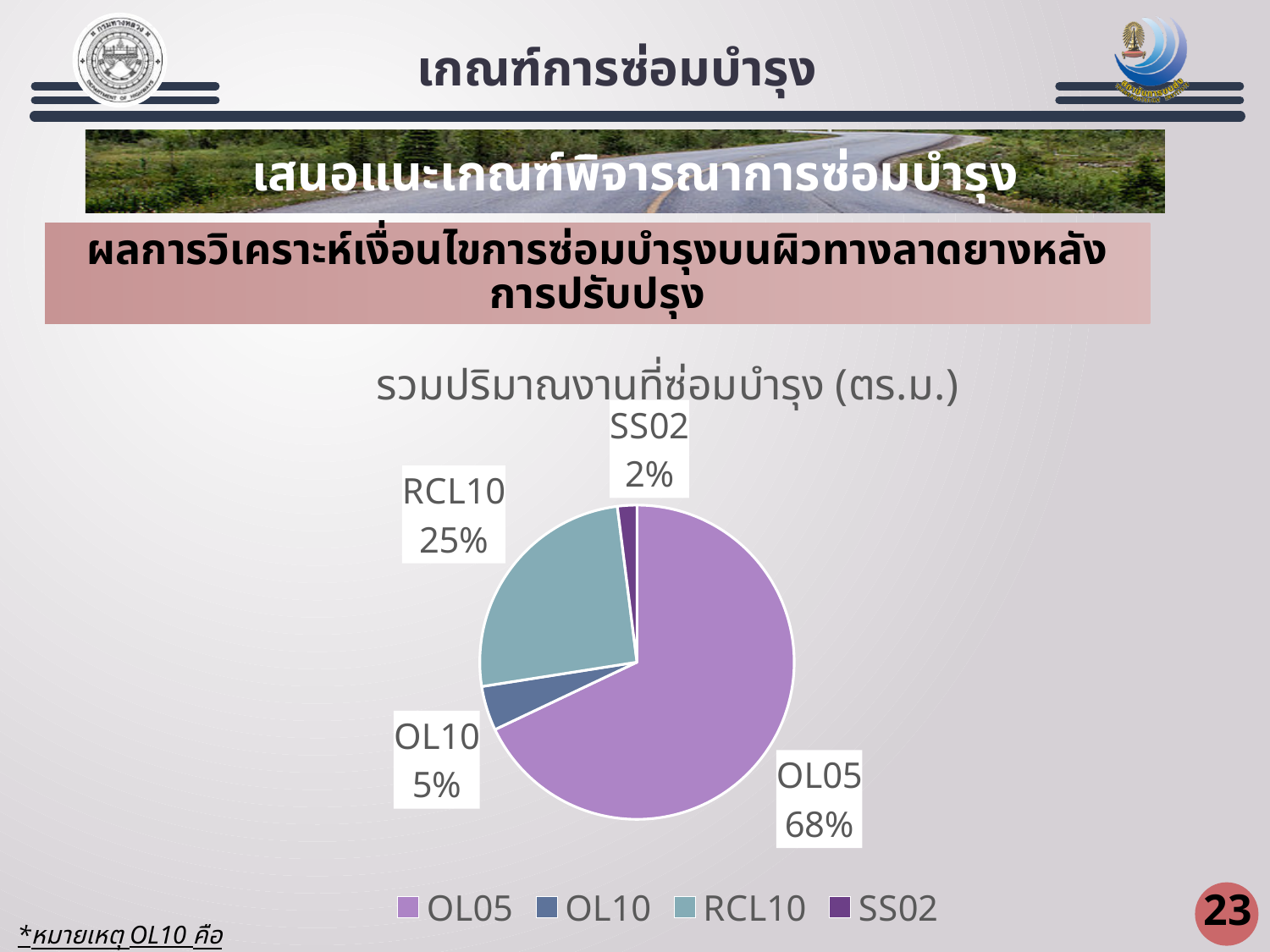
What kind of chart is shown on the slide? pie chart What is the title of the pie chart? รวมปริมาณงานที่ซ่อมบำรุง (ตร.ม.) What share of the pie does OL10 have? 5% How many entries does the legend list? 4 What is the difference in percentage points between OL05 and RCL10? 43 How many categories are shown in the pie chart? 4 Which category has the smallest slice of the pie? SS02 What share of the pie does RCL10 have? 25% What share of the pie does SS02 have? 2% Which is larger, the share for OL10 or the share for RCL10? RCL10 Which category has the largest slice of the pie? OL05